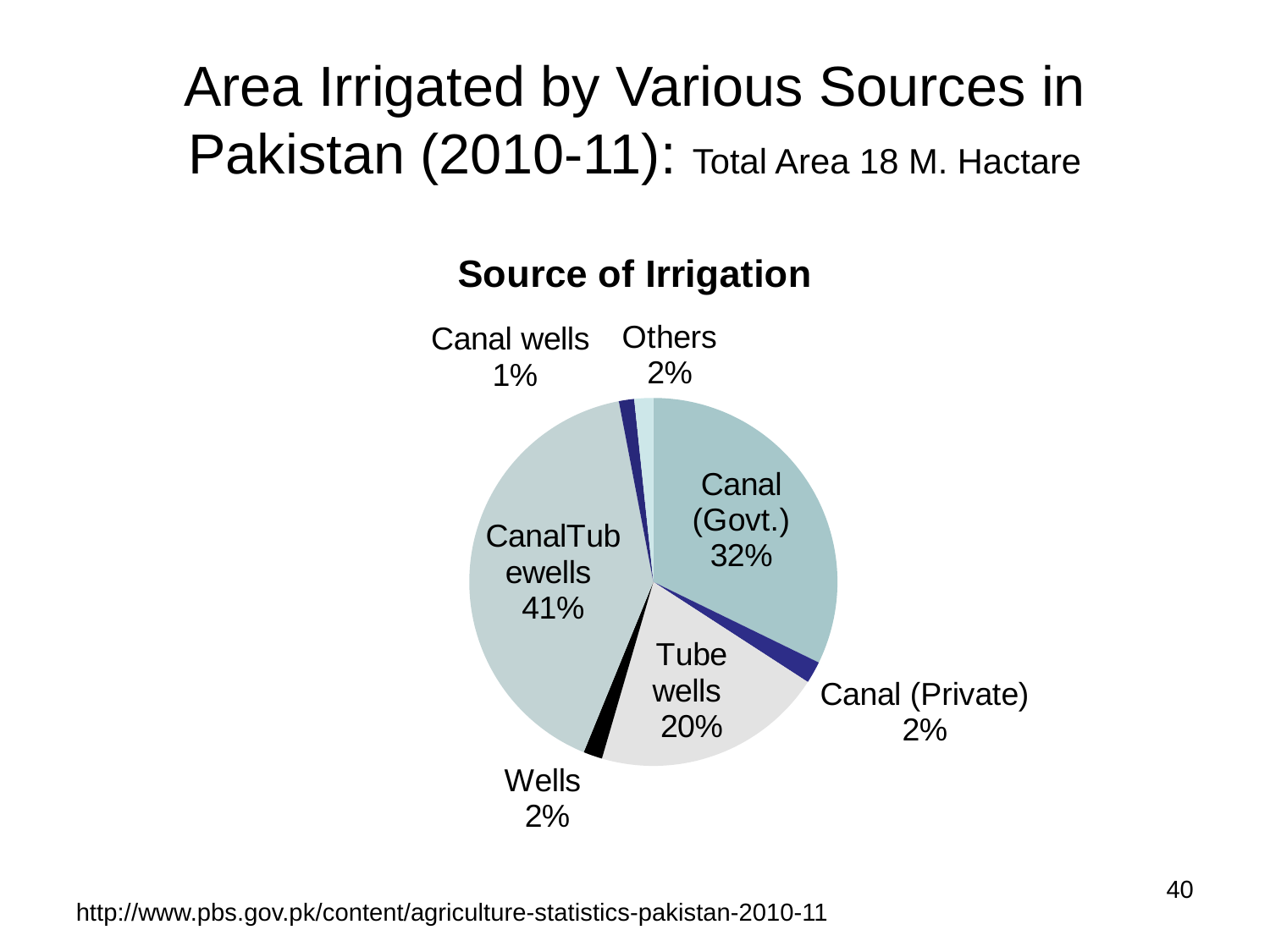
What is the difference in percentage points between Canal Tubewells and Canal (Govt.)? 9 What share of irrigated area comes from Canal wells? 1% What share of irrigated area comes from Canal Tubewells? 41% Which source of irrigation has the smallest share? Canal wells How many slices does the pie chart have? 7 What type of chart is shown on the slide? pie chart Which has a larger share, Canal (Govt.) or Tube wells? Canal (Govt.) What share of irrigated area comes from Tube wells? 20% What is the combined share of Canal (Govt.) and Canal (Private)? 34% Which source of irrigation has the largest share? CanalTubewells What is the chart's title? Source of Irrigation